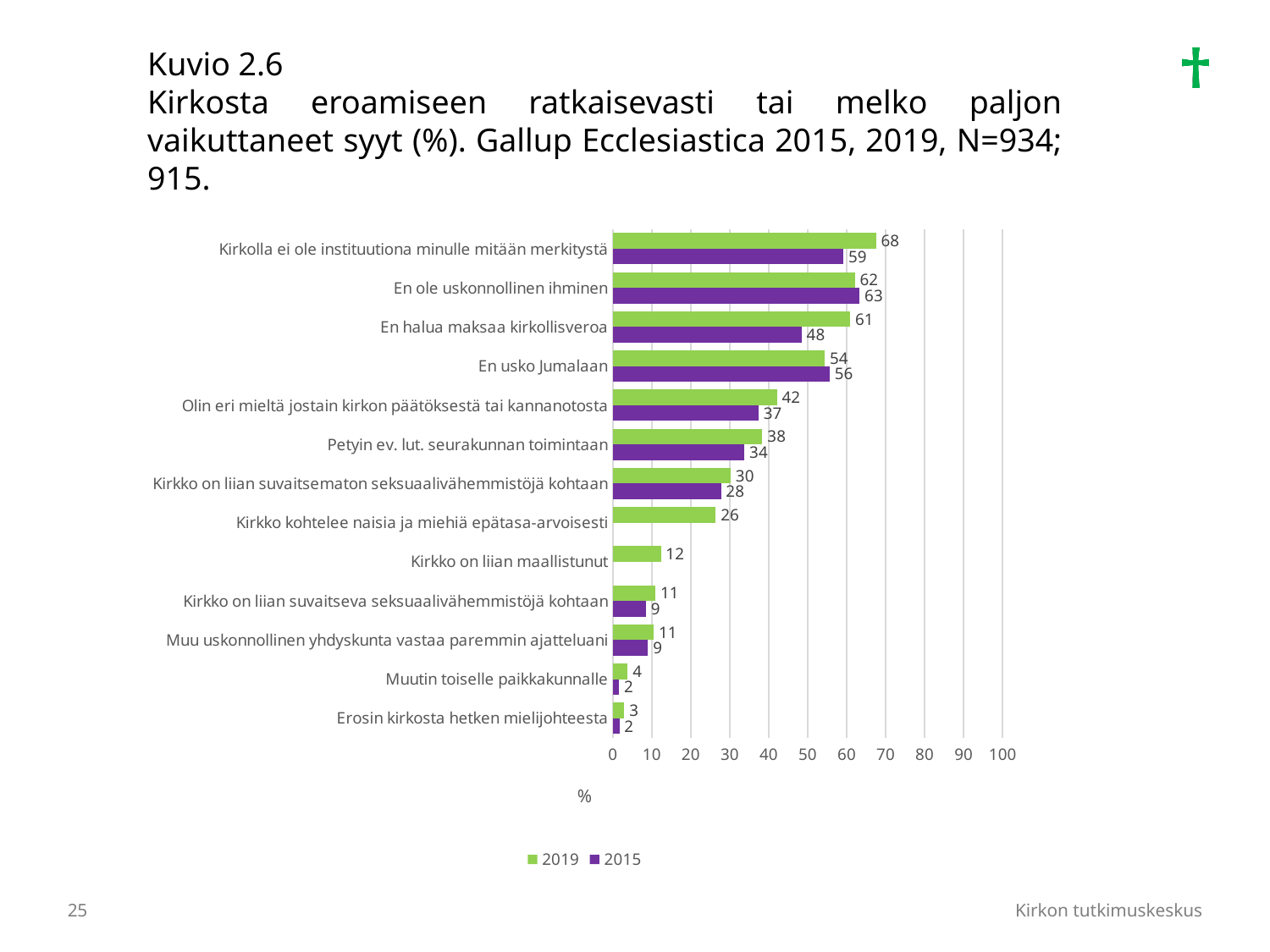
How many categories are shown on the chart? 13 What kind of chart is shown on the slide? Bar chart Which series is shown in green? 2019 What is the 2015 value for "En halua maksaa kirkollisveroa"? 48 What is the 2015 value for "Olin eri mieltä jostain kirkon päätöksestä tai kannanotosta"? 37 For "En ole uskonnollinen ihminen", which year has the larger value, 2019 or 2015? 2015 Which category has the lowest 2019 value? Erosin kirkosta hetken mielijohteesta What is the 2019 value for "Kirkolla ei ole instituutiona minulle mitään merkitystä"? 68 What is the difference between the 2019 and 2015 values for "Kirkolla ei ole instituutiona minulle mitään merkitystä"? 9 Which category has the highest 2019 value? Kirkolla ei ole instituutiona minulle mitään merkitystä What is the difference between the 2019 and 2015 values for "En halua maksaa kirkollisveroa"? 13 How many series does the legend list? 2